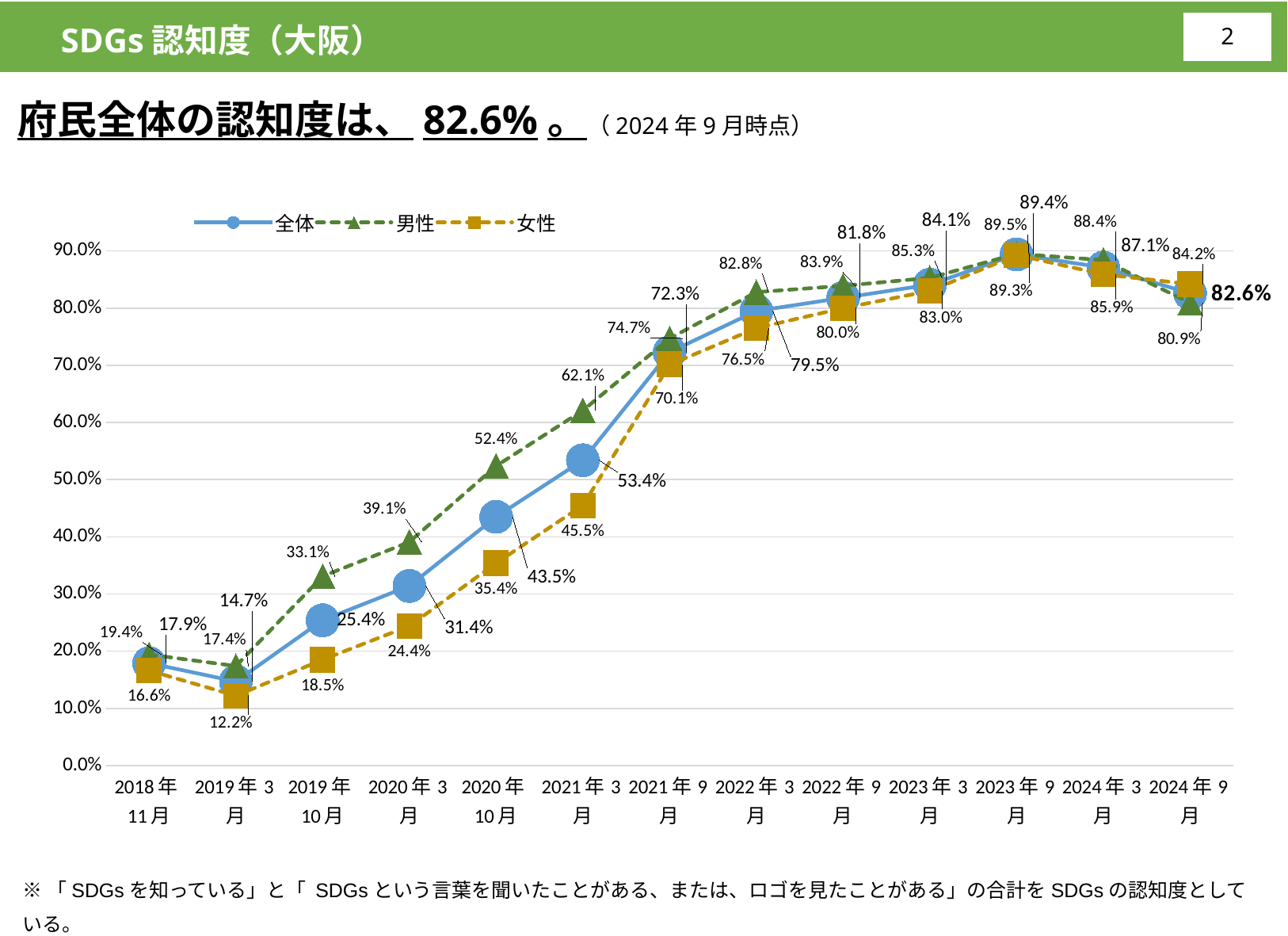
Which is larger at 2024年9月, the 男性 value or the 女性 value? 女性 What is the difference between the 男性 and 女性 values at 2019年10月? 14.6% Which series is drawn with triangle markers? 男性 What is the value for 男性 at 2021年3月? 62.1% How many time points are plotted along the x axis? 13 What is the value for 女性 at 2019年3月? 12.2% At which time point does the 全体 series reach its highest value? 2023年9月 What kind of chart is shown on the slide? line chart What is the value for 全体 at 2024年9月? 82.6% At which time point is the 女性 series at its lowest value? 2019年3月 Does the 全体 series generally rise or fall from 2019年3月 to 2023年9月? rise How many series does the legend list? 3